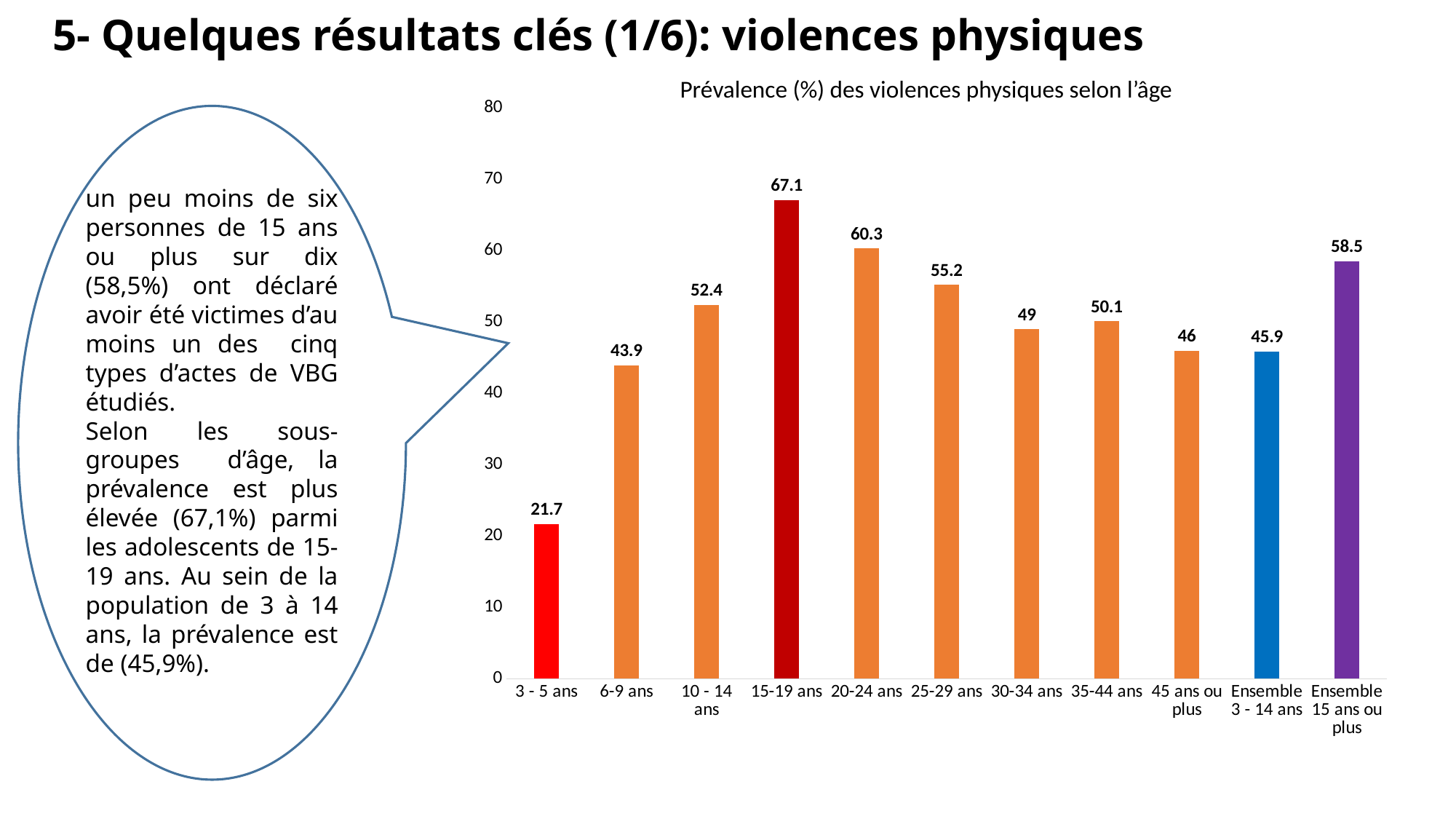
What is the value for the 3 - 5 ans category? 21.7 What is the title of the chart? Prévalence (%) des violences physiques selon l'âge What is the value for the 15-19 ans category? 67.1 What is the value for Ensemble 15 ans ou plus? 58.5 What kind of chart is shown on the slide? bar chart Which category has the highest value? 15-19 ans Is the value for 25-29 ans greater or less than 50? greater Which category has the lowest value? 3 - 5 ans How many categories are shown on the x axis? 11 What is the difference between the values for 15-19 ans and 20-24 ans? 6.8 What is the value for the 35-44 ans category? 50.1 Which is larger, the value for 6-9 ans or the value for 10 - 14 ans? 10 - 14 ans